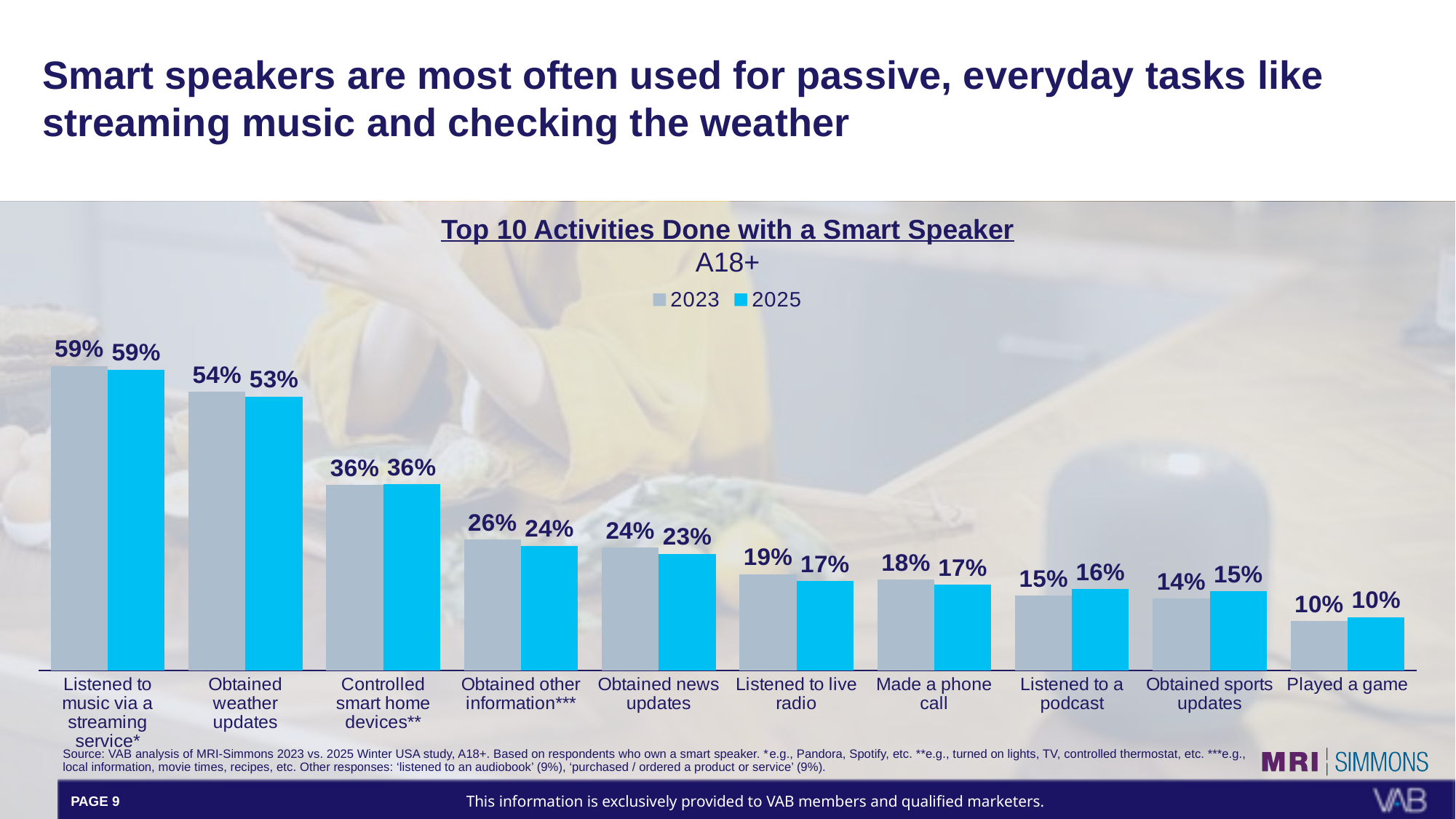
What is the title of the chart? Top 10 Activities Done with a Smart Speaker Which is larger for 'Obtained sports updates': the 2023 value or the 2025 value? 2025 Which activity has the highest 2025 value? Listened to music via a streaming service* How many series does the legend list? 2 What is the 2023 value for 'Listened to live radio'? 19% What is the 2025 value for 'Obtained weather updates'? 53% What is the difference between the 2023 and 2025 values for 'Obtained other information***'? 2% What is the 2025 value for 'Listened to a podcast'? 16% How many activities are shown on the x axis? 10 What kind of chart is shown? Bar chart Do the 2023 values rise or fall from left to right along the x axis? Fall Which activity has the lowest 2023 value? Played a game